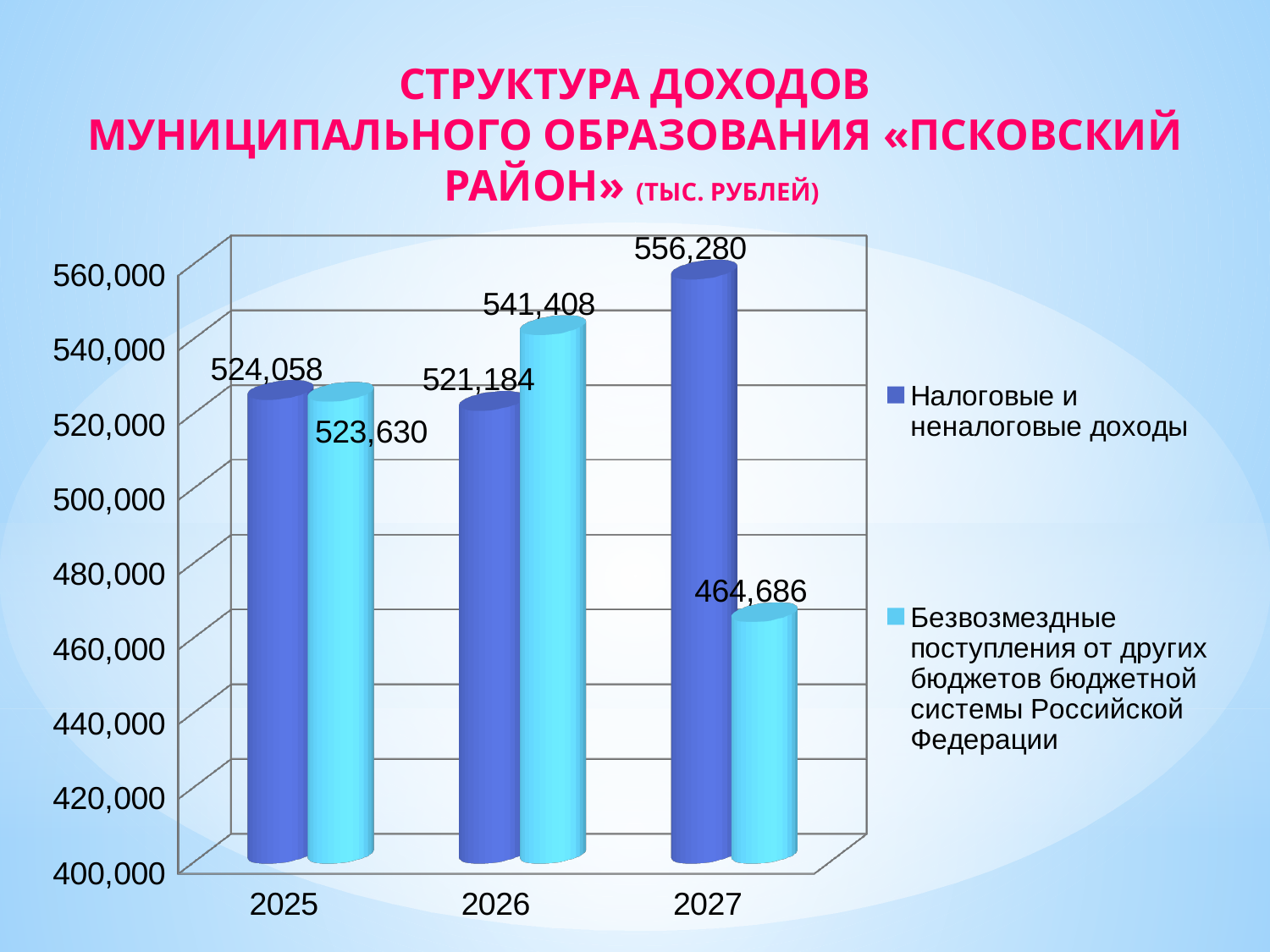
What is the difference between Налоговые и неналоговые доходы and Безвозмездные поступления in 2027? 91,594 What is the value of Безвозмездные поступления от других бюджетов бюджетной системы Российской Федерации for 2026? 541,408 In 2026, which series has the larger value: Налоговые и неналоговые доходы or Безвозмездные поступления? Безвозмездные поступления от других бюджетов бюджетной системы Российской Федерации Is the value for Безвозмездные поступления in 2027 greater or less than 480,000? less What type of chart is shown on the slide? Bar chart How many series does the legend list? 2 What is the value of Налоговые и неналоговые доходы for 2025? 524,058 Does Безвозмездные поступления rise or fall from 2026 to 2027? fall In which year is Налоговые и неналоговые доходы the highest? 2027 How many years are shown on the x axis? 3 What is the value of Налоговые и неналоговые доходы for 2027? 556,280 In which year is Безвозмездные поступления от других бюджетов the lowest? 2027